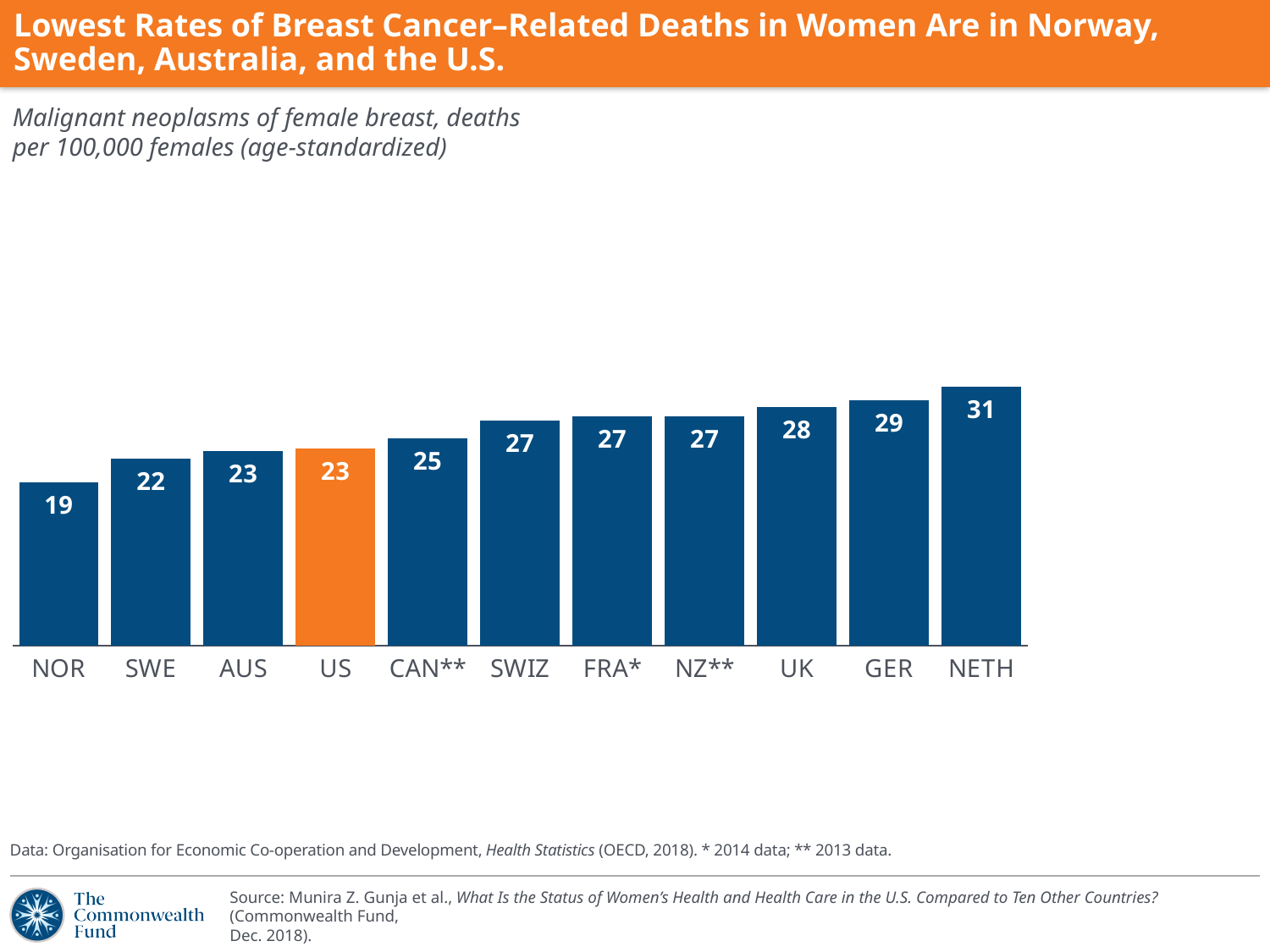
Which bar is highlighted in orange? US What is the difference between the values for NETH and NOR? 12 Which country has the highest value? NETH What is the difference between the values for GER and US? 6 Which country has the lowest value? NOR What is the value for UK? 28 What is the value for the US? 23 What kind of chart is shown on the slide? Bar chart Do the values rise or fall from left to right along the x axis? Rise What is the value for NOR? 19 Which is larger, the value for CAN** or the value for SWE? CAN** How many countries are shown in the chart? 11